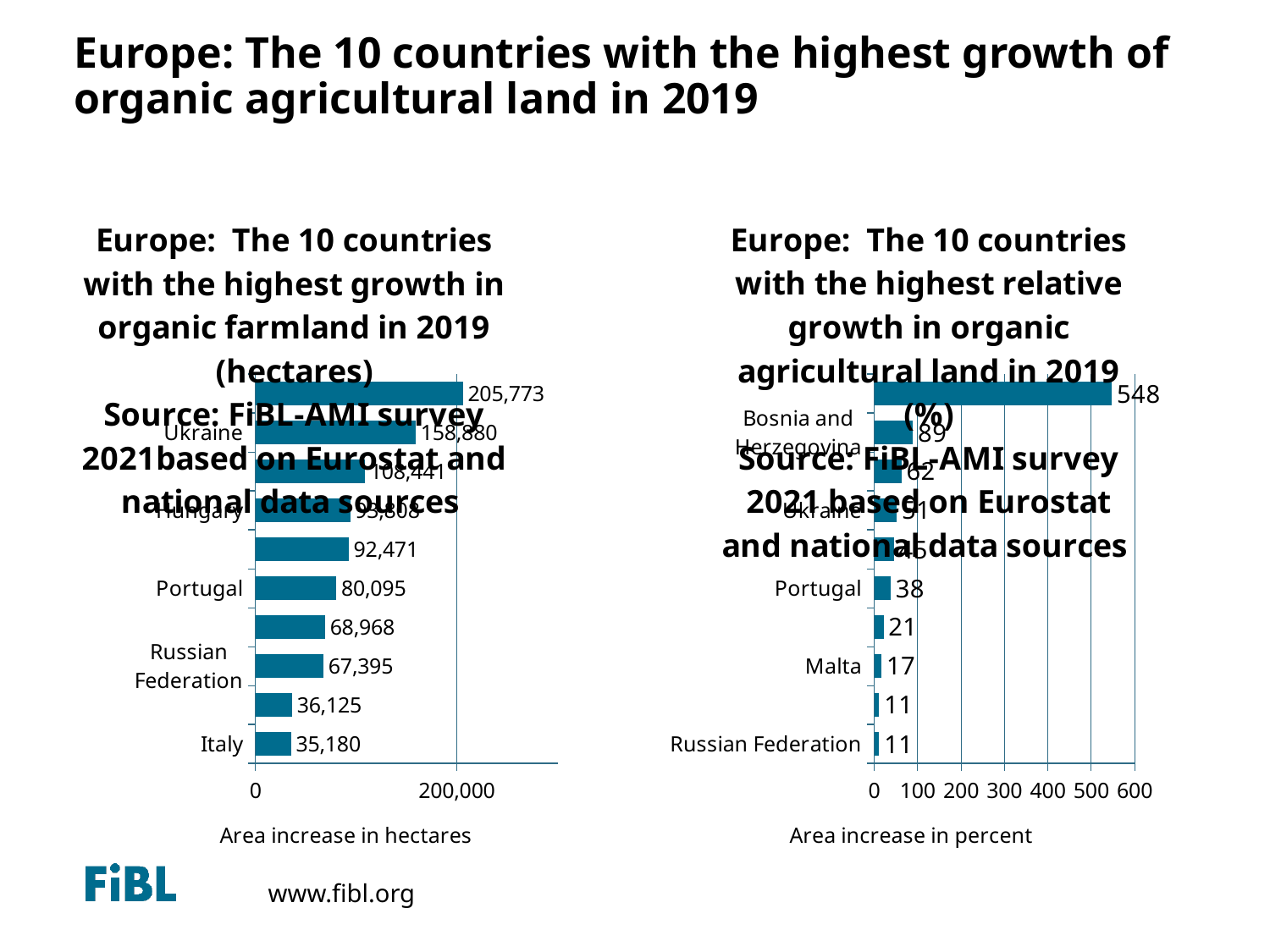
In the right chart (relative growth in %), what is the area increase in percent for Portugal? 38 In the left chart (growth in hectares), which has the larger area increase, Portugal or the Russian Federation? Portugal In the right chart (relative growth in %), which has the larger value, Portugal or Malta? Portugal In the right chart (relative growth in %), what is the area increase in percent for Malta? 17 In the left chart (growth in hectares), how much larger is Portugal's area increase than Italy's? 44,915 In the left chart (growth in hectares), what is the area increase for Portugal? 80,095 In the right chart (relative growth in %), what is the area increase in percent for the Russian Federation? 11 In the right chart (relative growth in %), how many bars are plotted? 10 What type of chart is the left chart (growth in organic farmland in hectares)? bar chart In the left chart (growth in hectares), is the value for Ukraine greater or less than 200,000? less In the left chart (growth in hectares), what is the area increase for Italy? 35,180 In the left chart (growth in hectares), what is the area increase for the Russian Federation? 67,395